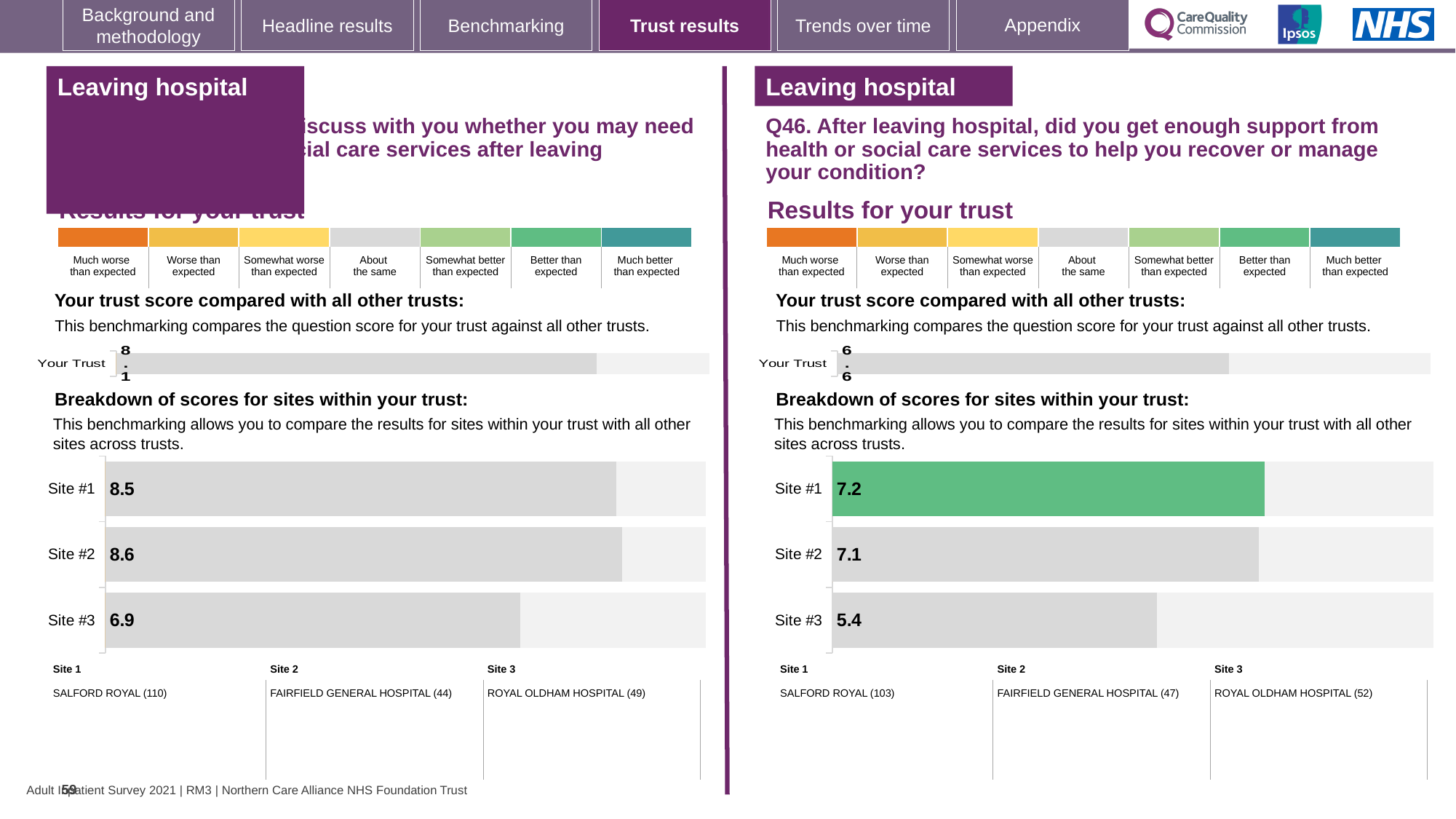
On the right-hand (Q46) site breakdown chart, what is the score for Site #3? 5.4 On the right-hand (Q46) site breakdown chart, which site has the lowest score? Site #3 On the left-hand 'Your trust score compared with all other trusts' chart, what is the score for Your Trust? 8.1 On the right-hand (Q46) site breakdown chart, how many sites are shown? 3 On the left-hand site breakdown chart, what is the score for Site #3? 6.9 On the right-hand (Q46) site breakdown chart, what is the difference between the scores for Site #1 and Site #3? 1.8 What type of chart is used for the site breakdown on the right-hand (Q46) side of the slide? Bar chart On the left-hand site breakdown chart, what is the score for Site #2? 8.6 On the right-hand (Q46) site breakdown chart, what is the score for Site #1? 7.2 On the left-hand site breakdown chart, what is the difference between the scores for Site #2 and Site #3? 1.7 On the left-hand site breakdown chart, which site has the lowest score? Site #3 On the right-hand (Q46) 'Your trust score compared with all other trusts' chart, what is the score for Your Trust? 6.6